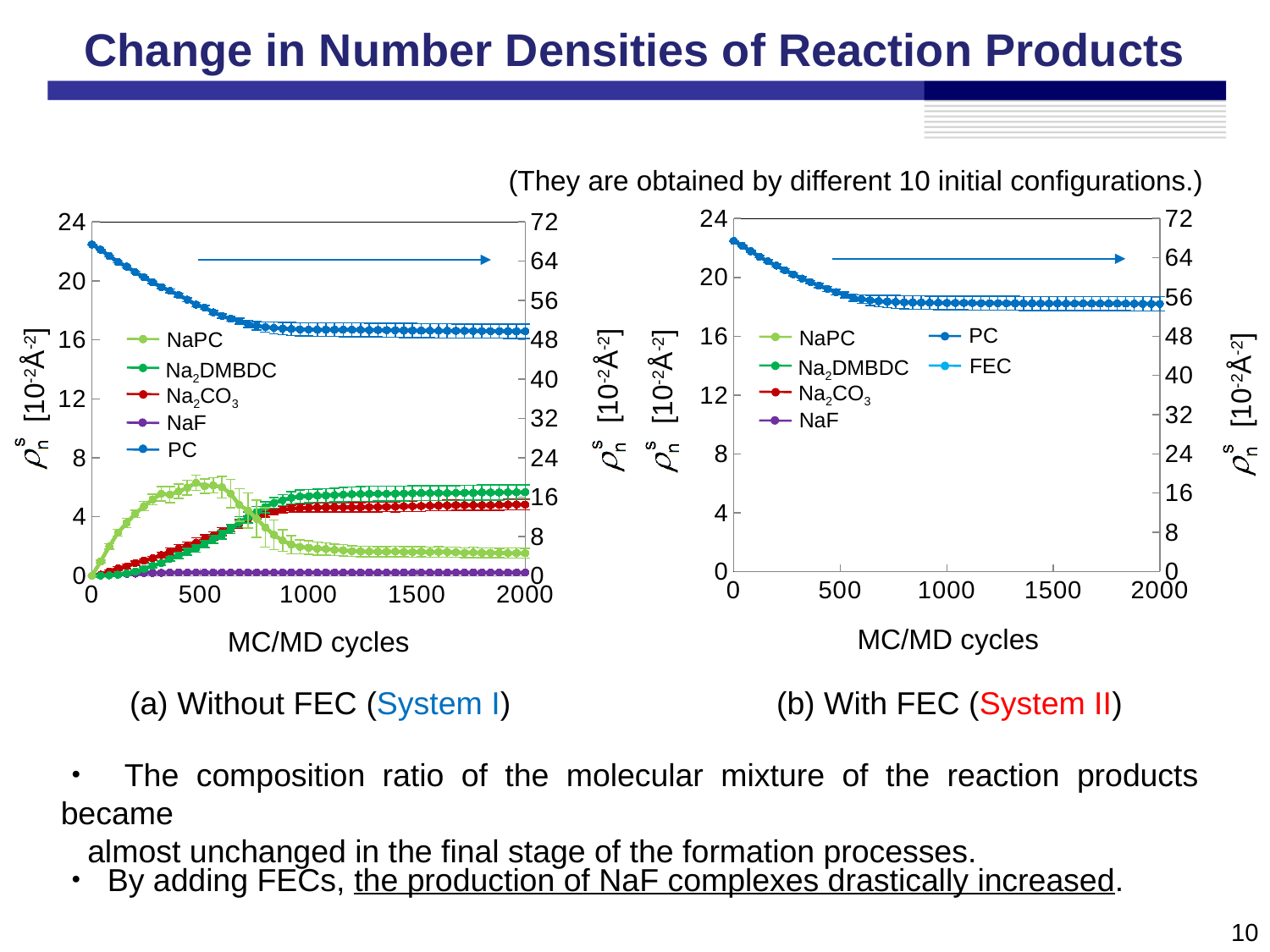
In chart (a) Without FEC (System I), is the NaPC value at 500 MC/MD cycles greater or less than 4 on the left axis? greater What is the x-axis label of chart (b) With FEC (System II)? MC/MD cycles What is the largest tick value shown on the x axis of chart (a) Without FEC (System I)? 2000 In chart (a) Without FEC (System I), which series has the highest values across the whole range? PC In chart (a) Without FEC (System I), at 2000 MC/MD cycles, which is larger: Na2DMBDC or Na2CO3? Na2DMBDC What kind of chart is chart (a) Without FEC (System I)? line chart How many series does the legend of chart (b) With FEC (System II) list? 6 In chart (a) Without FEC (System I), is the NaPC value at 2000 MC/MD cycles greater or less than 4 on the left axis? less In chart (a) Without FEC (System I), which series has the lowest values across the whole range? NaF In chart (b) With FEC (System II), is the PC value at 0 MC/MD cycles greater or less than 64 on the right axis? greater How many series does the legend of chart (a) Without FEC (System I) list? 5 In chart (a) Without FEC (System I), does the PC series rise or fall as MC/MD cycles increase? fall